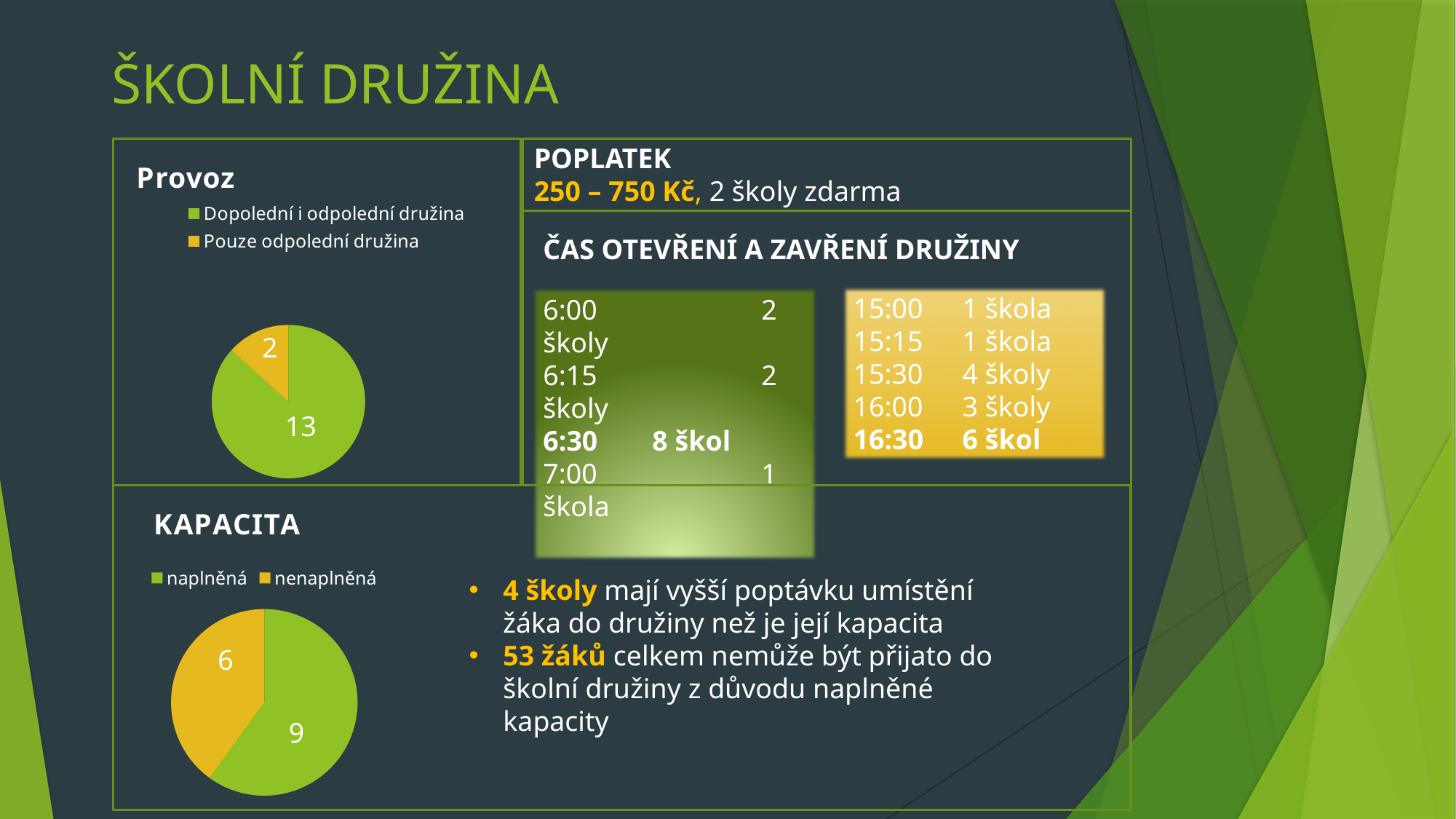
In the Provoz chart, what is the total of the two slices? 15 In the Provoz chart, what is the value for Dopolední i odpolední družina? 13 In the KAPACITA chart, which category has the smaller slice? nenaplněná In the Provoz chart, what is the value for Pouze odpolední družina? 2 In the KAPACITA chart, what is the value for naplněná? 9 In the KAPACITA chart, what is the value for nenaplněná? 6 What kind of chart is the Provoz chart? Pie chart In the Provoz chart, what is the difference between the two slices? 11 How many entries does the legend of the KAPACITA chart list? 2 In the KAPACITA chart, what is the difference between naplněná and nenaplněná? 3 In the KAPACITA chart, what share of the total does naplněná represent? 60% In the Provoz chart, which category has the largest slice? Dopolední i odpolední družina